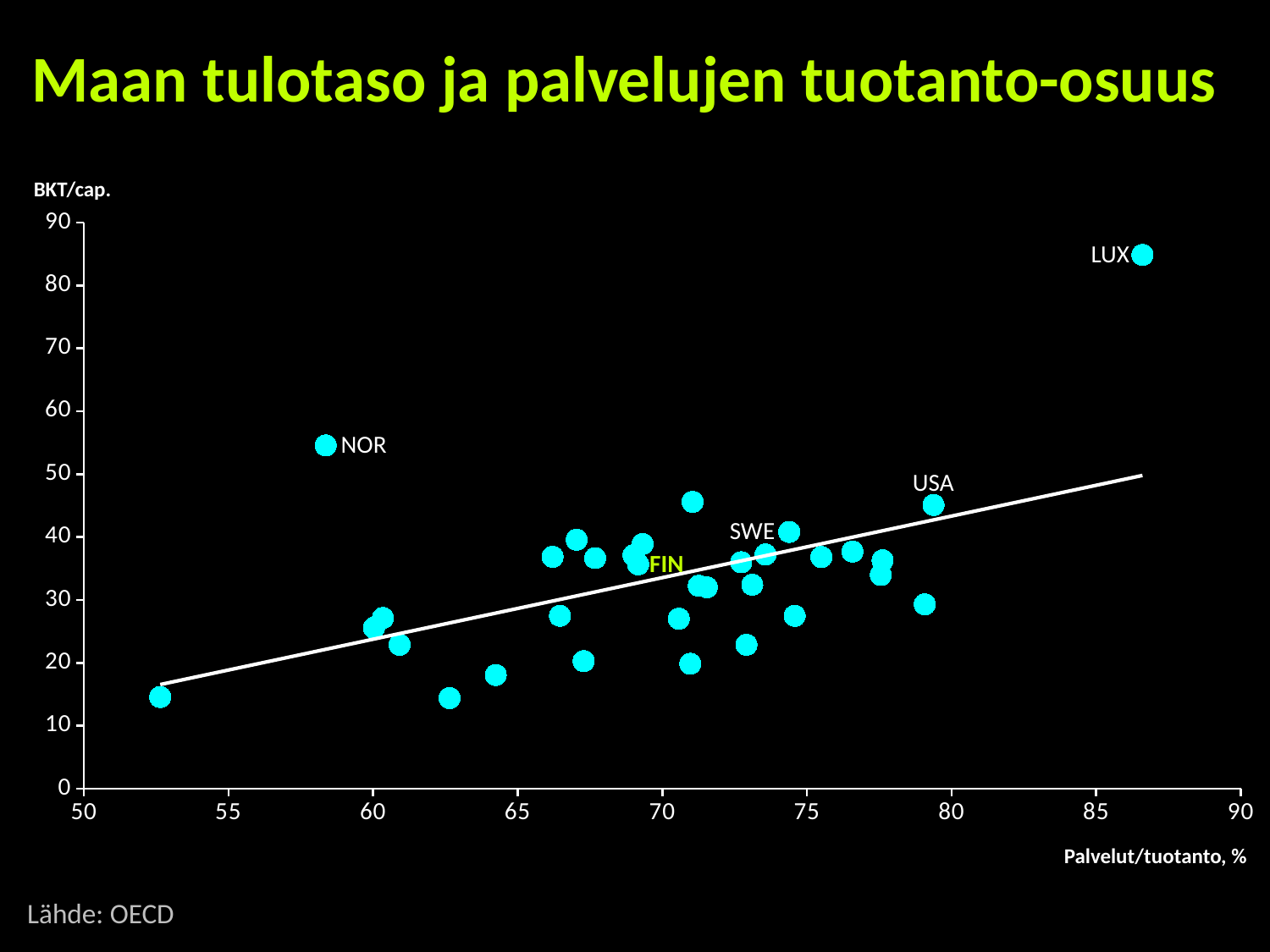
Is the BKT/cap. value for NOR greater or less than 50? greater Which labelled country has the highest BKT/cap. value? LUX What is the label of the horizontal axis? Palvelut/tuotanto, % Which has the higher BKT/cap. value, NOR or USA? NOR Is the BKT/cap. value for FIN greater or less than 40? less Is the Palvelut/tuotanto, % value for NOR greater or less than 60? less What kind of chart is shown on the slide? scatter chart What is the title of the chart? Maan tulotaso ja palvelujen tuotanto-osuus Which has the higher Palvelut/tuotanto, % value, FIN or SWE? SWE